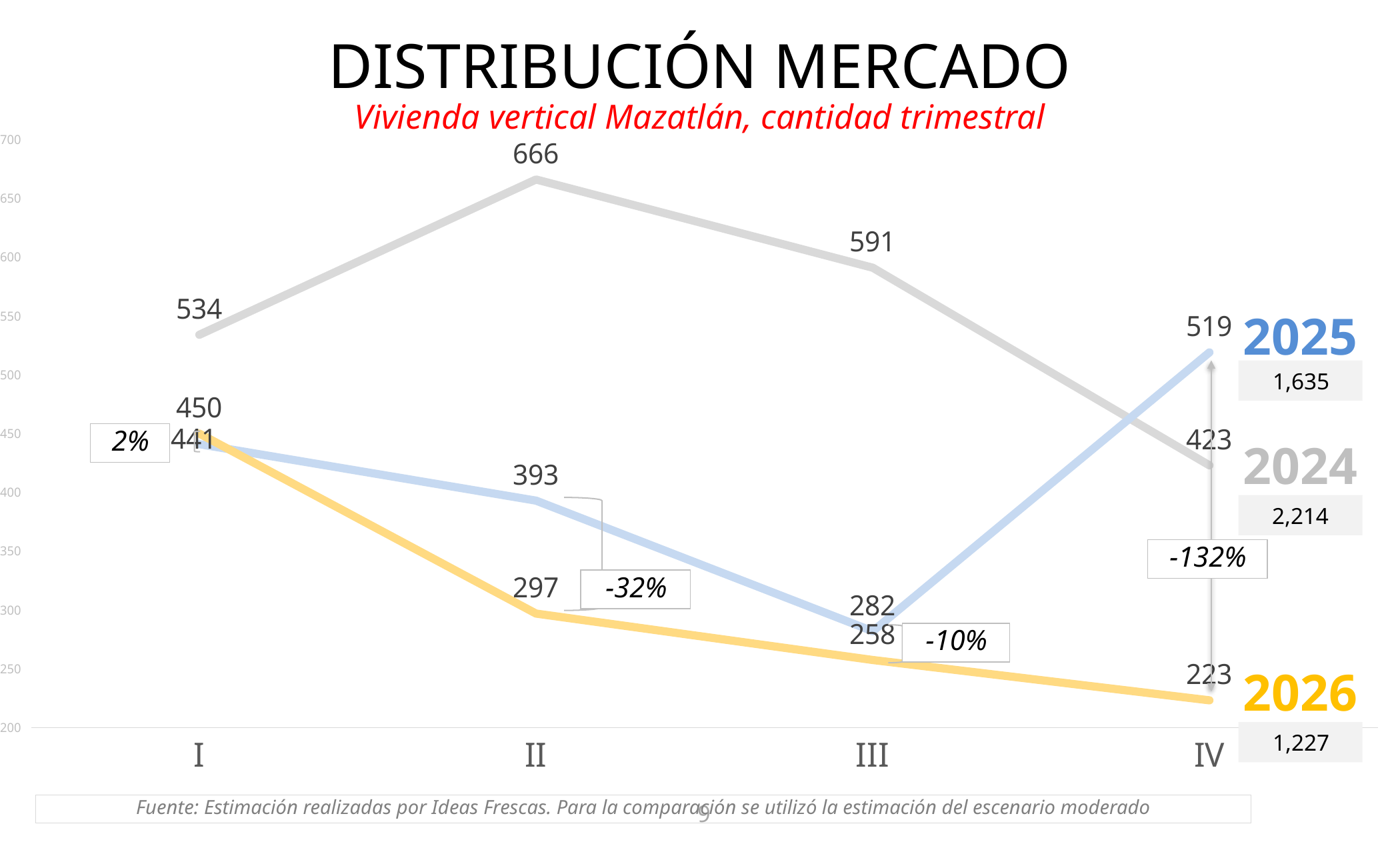
What is the value for 2025 in quarter IV? 519 In which quarter does the 2024 series reach its highest value? II How many quarters are shown on the x axis? 4 In which quarter does the 2024 series have its lowest value? IV Does the 2026 series rise or fall from quarter I to quarter IV? fall How many series (years) are plotted on the chart? 3 What is the value for 2024 in quarter II? 666 What is the difference between the 2024 values for quarter II and quarter III? 75 What is the value for 2026 in quarter IV? 223 What kind of chart is shown on the slide? line chart What annual total is shown for 2024? 2,214 In quarter III, which series has the larger value, 2025 or 2026? 2025